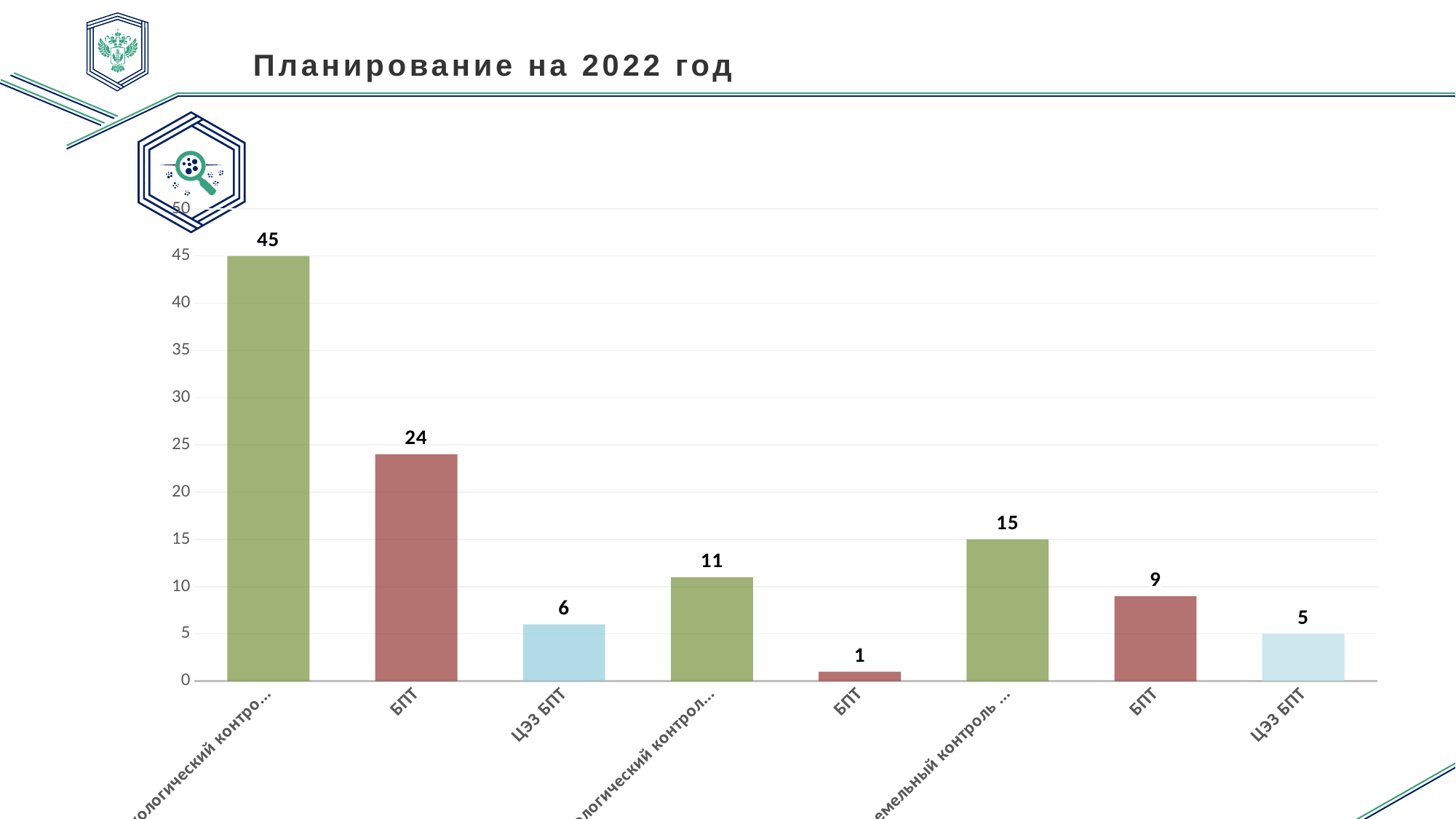
What is the value of the third bar from the left, labelled ЦЭЗ БПТ? 6 What is the difference between the first bar (45) and the second bar (24)? 21 What is the value of the first (leftmost) bar in the chart? 45 Which bar has the lowest value in the chart? the fifth bar (БПТ), 1 What type of chart is shown on the slide? bar chart What is the title of the chart on the slide? Планирование на 2022 год What is the value of the second bar from the left, labelled БПТ? 24 What is the value of the last (rightmost) bar, labelled ЦЭЗ БПТ? 5 How many bars are plotted in the chart? 8 What is the value of the fifth bar from the left, labelled БПТ? 1 Which bar has the highest value in the chart? the first (leftmost) bar, 45 Which is larger: the sixth bar (15) or the seventh bar labelled БПТ (9)? the sixth bar, 15